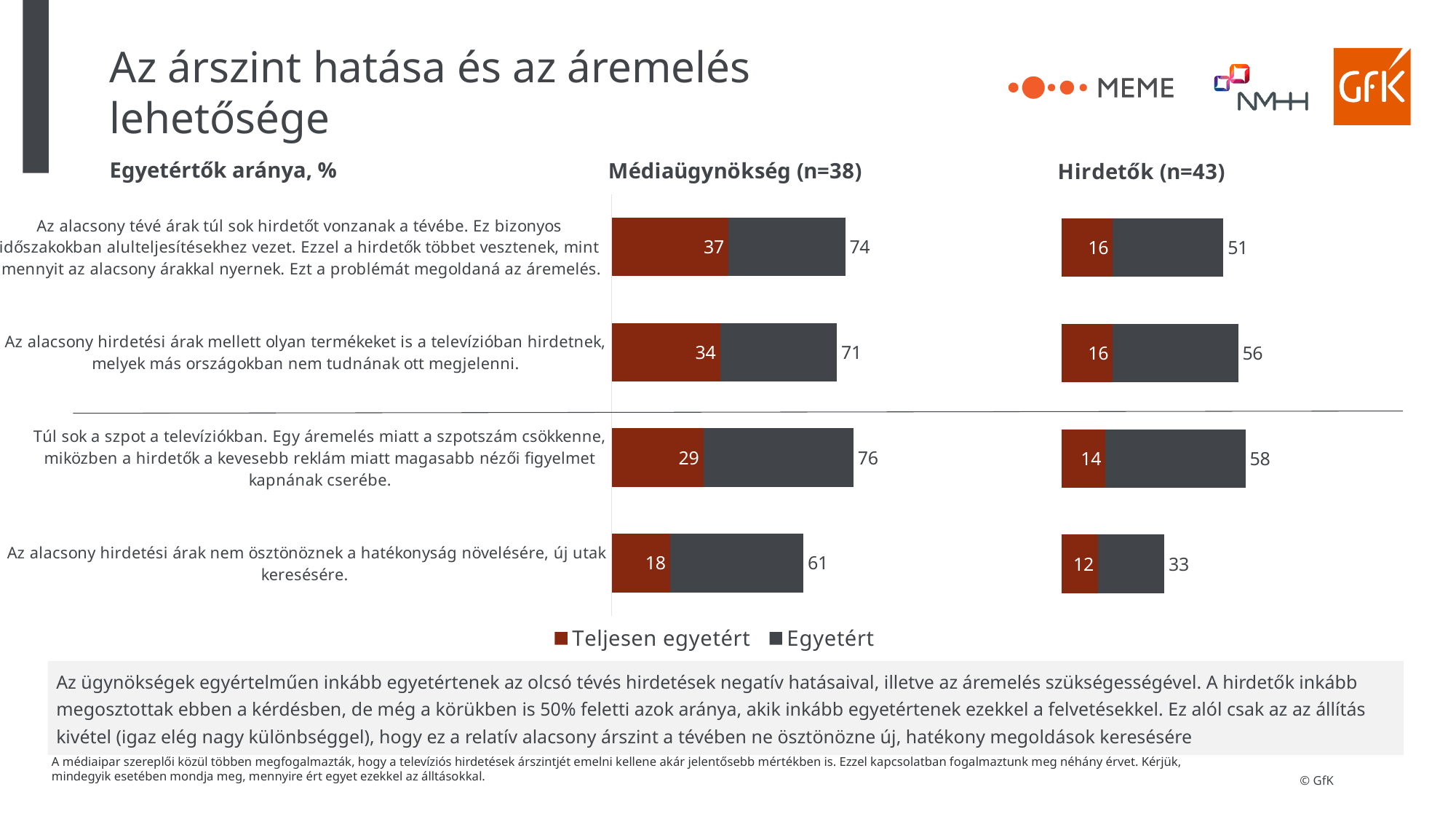
What type of chart is used on this slide? Stacked horizontal bar chart In the Médiaügynökség (n=38) chart, which statement has the highest total agreement? Túl sok a szpot a televíziókban (third bar, 76) In the Hirdetők (n=43) chart, what is the 'Teljesen egyetért' value for the bottom statement (low prices do not encourage efficiency)? 12 How many statements (bars) are shown in each chart? 4 In the Médiaügynökség (n=38) chart, what is the 'Egyetért' (grey) portion for the bottom statement, given the 'Teljesen egyetért' value of 18 and the total of 61? 43 For the second statement (products advertised that could not appear in other countries), is the total agreement higher among Médiaügynökség or Hirdetők? Médiaügynökség Which legend entry is shown in dark red? Teljesen egyetért In the Hirdetők (n=43) chart, which statement has the lowest total agreement? Az alacsony hirdetési árak nem ösztönöznek a hatékonyság növelésére (bottom bar, 33) In the Hirdetők (n=43) chart, what is the total agreement shown at the end of the bar for the statement about too many spots on television (third bar)? 58 In the Médiaügynökség (n=38) chart, what is the 'Teljesen egyetért' value for the top statement (about low TV prices attracting too many advertisers)? 37 What is the difference between the total agreement for the top statement in the Médiaügynökség chart (74) and in the Hirdetők chart (51)? 23 How many series does the legend list? 2